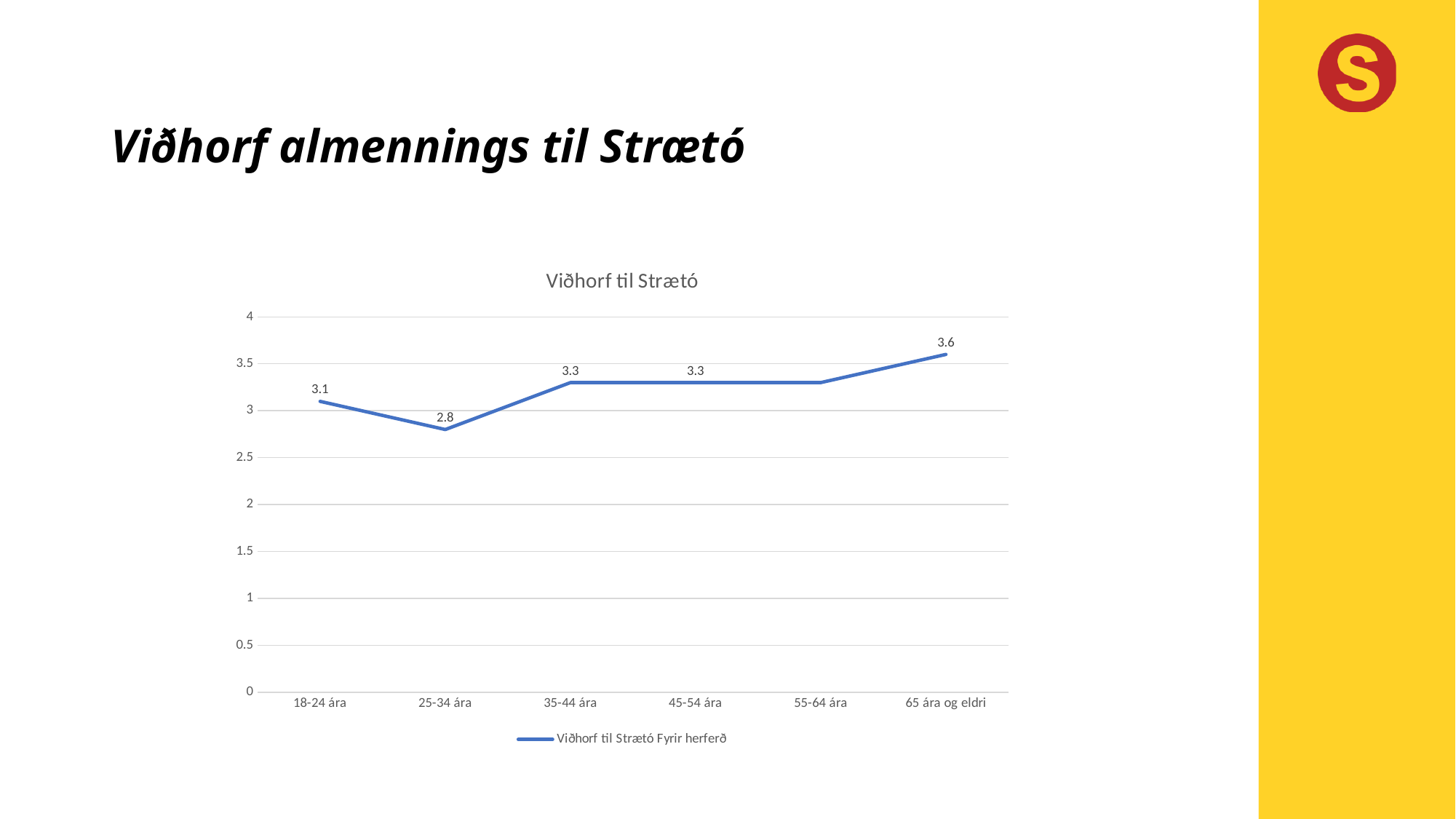
What kind of chart is shown? line chart What is the value for 65 ára og eldri? 3.6 Which age group has the lowest value? 25-34 ára What is the difference between the values for 65 ára og eldri and 25-34 ára? 0.8 Which age group has the highest value? 65 ára og eldri Which is larger, the value for 18-24 ára or the value for 25-34 ára? 18-24 ára What is the value for 18-24 ára? 3.1 How many age groups are shown on the x axis? 6 What is the value for 25-34 ára? 2.8 Is the value for 55-64 ára greater or less than 3? greater How many series does the legend list? 1 What is the title of the chart? Viðhorf til Strætó